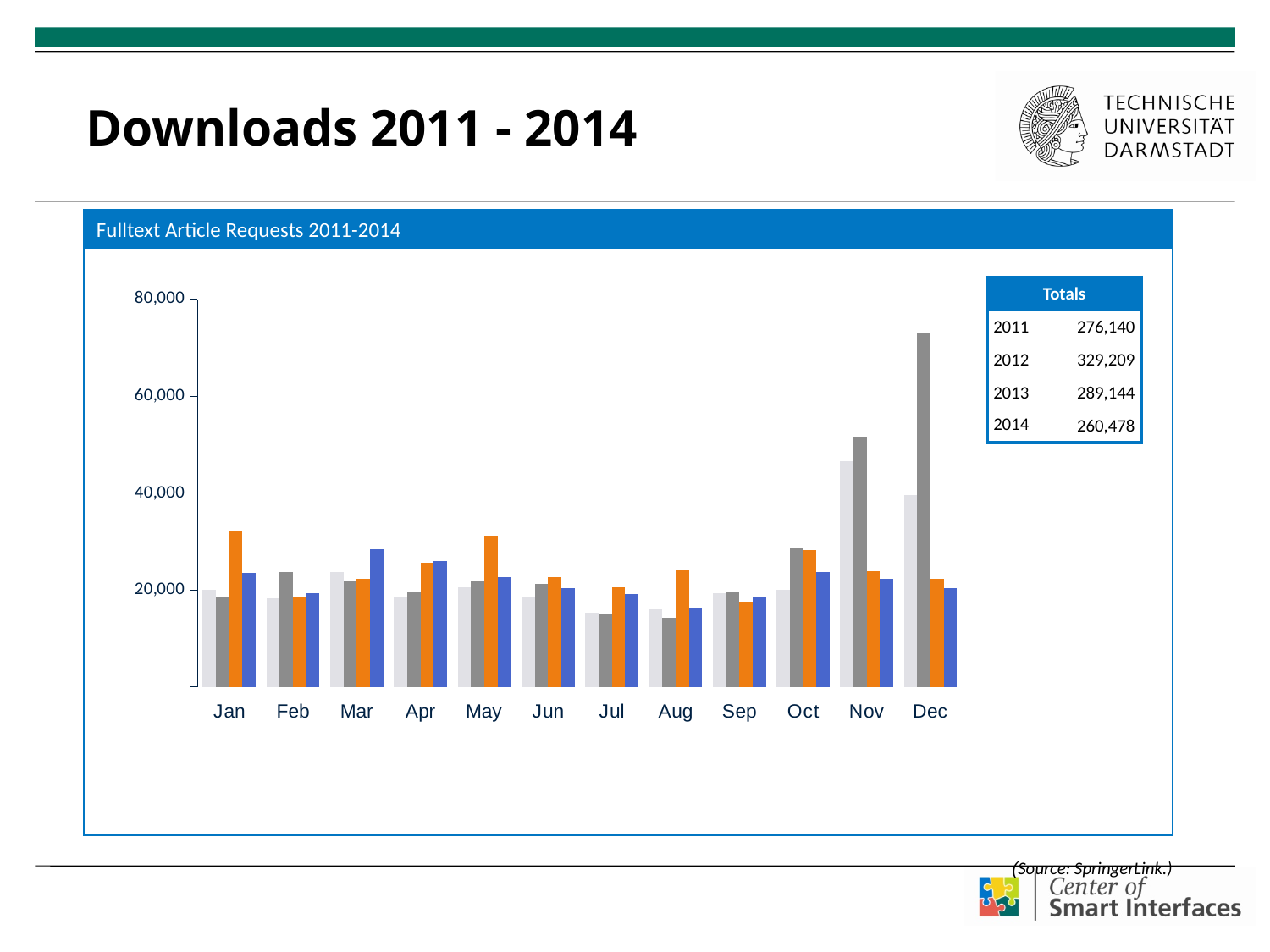
What is the difference between the 2012 total and the 2011 total in the Totals table? 53,069 Which total is larger in the Totals table, 2013 or 2014? 2013 Is the value of the dark gray bar for Dec greater or less than 60,000? greater What type of chart is shown on the slide? bar chart According to the Totals table, what is the total for 2014? 260,478 Which year has the highest total in the Totals table? 2012 According to the Totals table, what is the total for 2012? 329,209 How many bars are plotted for each month in the chart? 4 How many months are shown on the x axis of the chart? 12 Which year has the lowest total in the Totals table? 2014 What is the title of the chart? Fulltext Article Requests 2011-2014 Is the value of the dark gray bar for Aug greater or less than 20,000? less